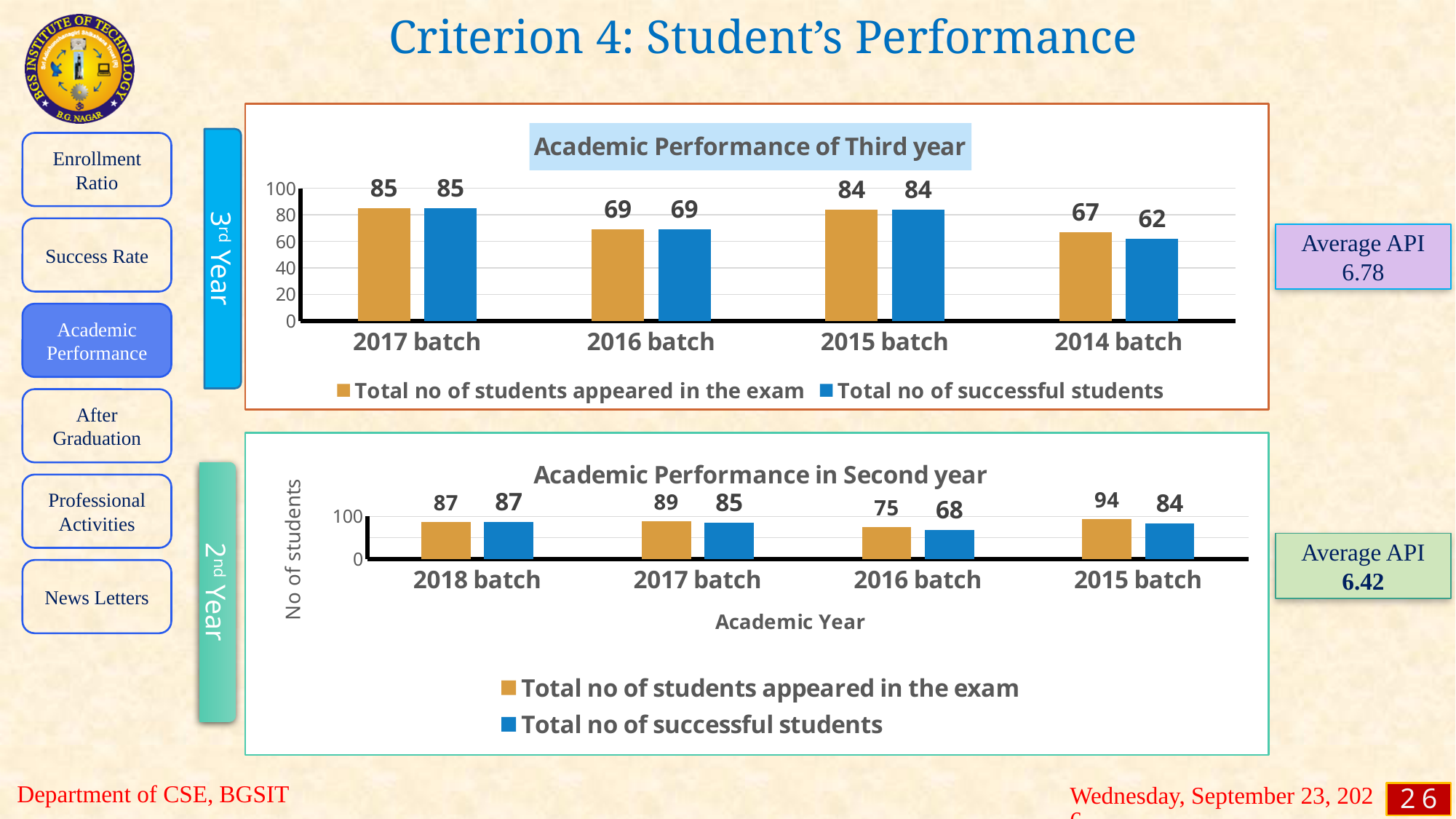
In the 'Academic Performance of Third year' chart, what is the difference between students appeared and successful students for the 2014 batch? 5 What type of chart is the 'Academic Performance of Third year' chart? bar chart In the 'Academic Performance of Third year' chart, which batch has the lowest number of successful students? 2014 batch How many series does the legend of the 'Academic Performance in Second year' chart list? 2 In the 'Academic Performance of Third year' chart, what is the total number of successful students for the 2014 batch? 62 In the 'Academic Performance of Third year' chart, what is the total number of students appeared in the exam for the 2016 batch? 69 In the 'Academic Performance in Second year' chart, what is the difference between students appeared and successful students for the 2015 batch? 10 In the 'Academic Performance in Second year' chart, what is the total number of students appeared in the exam for the 2015 batch? 94 In the 'Academic Performance in Second year' chart, what is the total number of successful students for the 2016 batch? 68 In the 'Academic Performance in Second year' chart, is the number of successful students for the 2017 batch larger or smaller than for the 2016 batch? larger In the 'Academic Performance of Third year' chart, how many batches are shown on the x axis? 4 In the 'Academic Performance in Second year' chart, which batch has the highest number of students appeared in the exam? 2015 batch